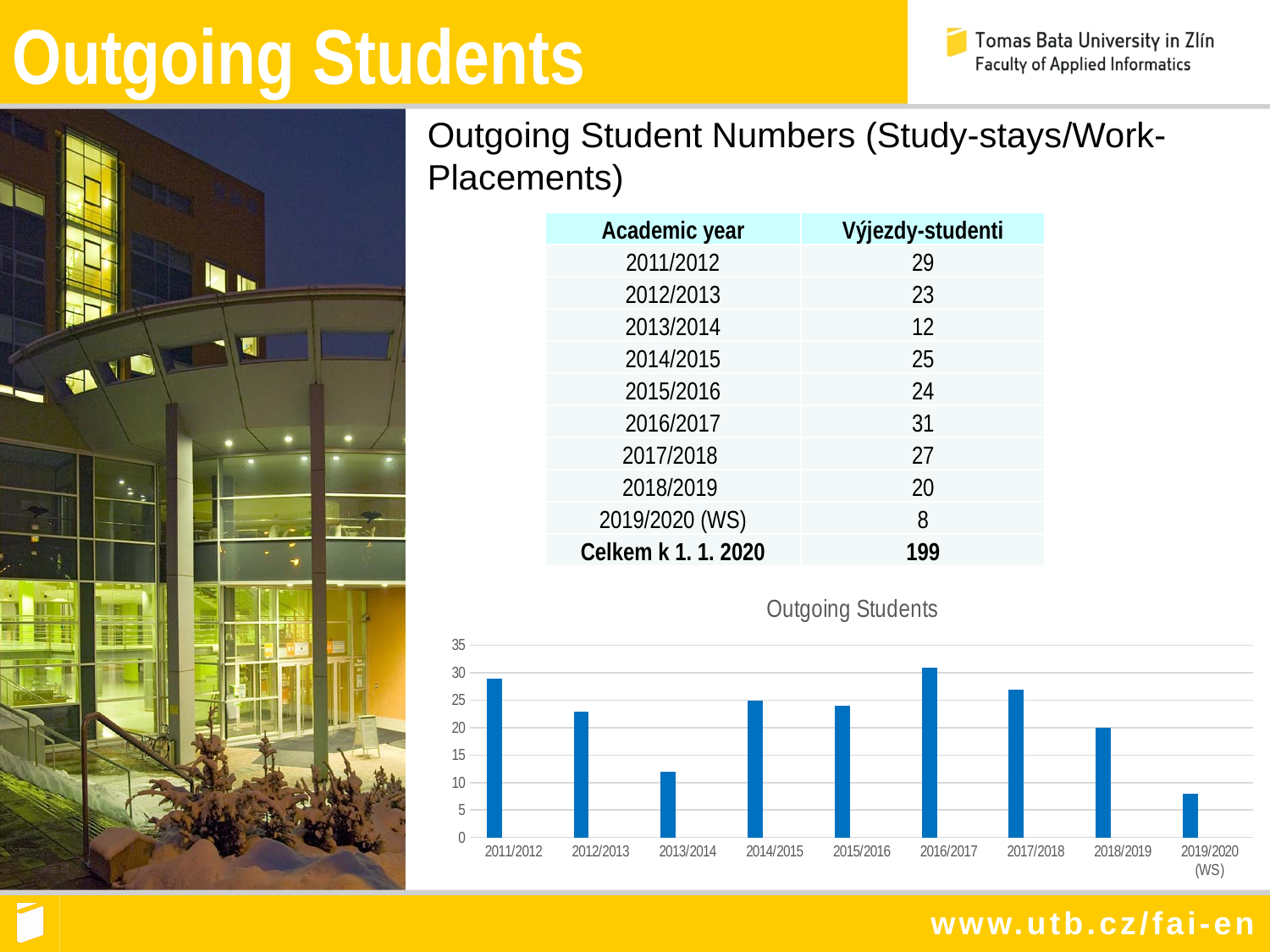
What type of chart is shown under the title "Outgoing Students"? bar chart Is the bar for 2019/2020 (WS) in the Outgoing Students chart greater or less than 10? less What is the difference between the outgoing student numbers for 2016/2017 and 2013/2014? 19 Which is larger in the Outgoing Students chart, the bar for 2012/2013 or the bar for 2014/2015? 2014/2015 What is the title of the bar chart on the slide? Outgoing Students Which academic year has the highest bar in the Outgoing Students chart? 2016/2017 What is the number of outgoing students for 2011/2012? 29 What is the number of outgoing students for 2018/2019? 20 Is the bar for 2016/2017 in the Outgoing Students chart greater or less than 30? greater How many academic years are plotted on the x axis of the Outgoing Students chart? 9 Which academic year has the lowest bar in the Outgoing Students chart? 2019/2020 (WS) What is the number of outgoing students for 2013/2014? 12